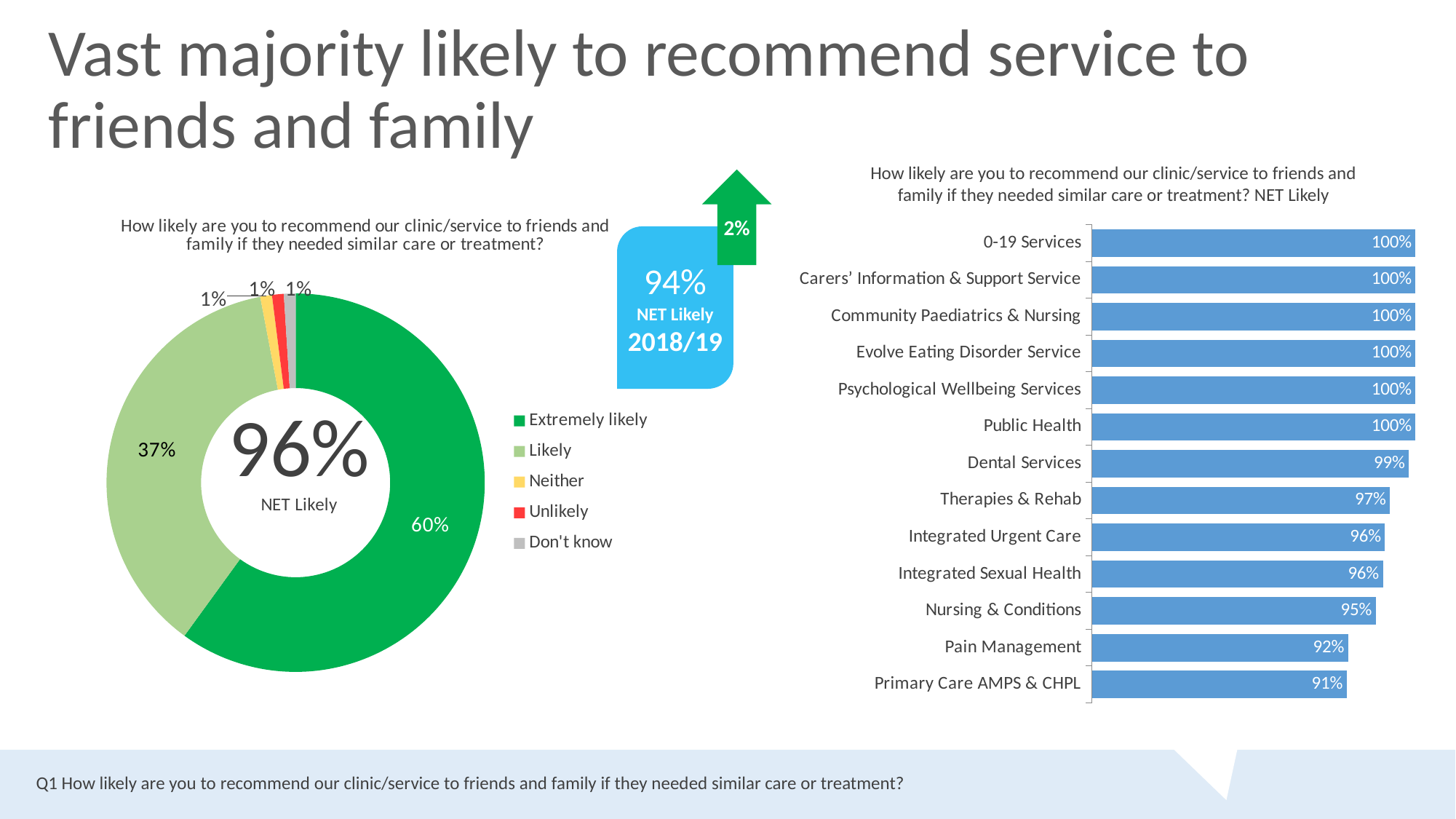
In the doughnut chart on the left, which response category has the largest share? Extremely likely In the bar chart on the right (NET Likely by service), what is the value for Therapies & Rehab? 97% What NET Likely figure is shown in the centre of the doughnut chart on the left? 96% In the bar chart on the right (NET Likely by service), which is higher: Dental Services or Nursing & Conditions? Dental Services In the bar chart on the right (NET Likely by service), which service has the lowest value? Primary Care AMPS & CHPL In the bar chart on the right (NET Likely by service), how many services are listed? 13 What type of chart is shown on the right of the slide? Bar chart In the doughnut chart on the left, what percentage of respondents said 'Likely'? 37% In the bar chart on the right (NET Likely by service), what is the value for Pain Management? 92% In the doughnut chart on the left, how many response categories does the legend list? 5 In the doughnut chart on the left, what percentage of respondents said 'Extremely likely'? 60% In the doughnut chart on the left, what is the difference between the 'Extremely likely' and 'Likely' shares? 23%